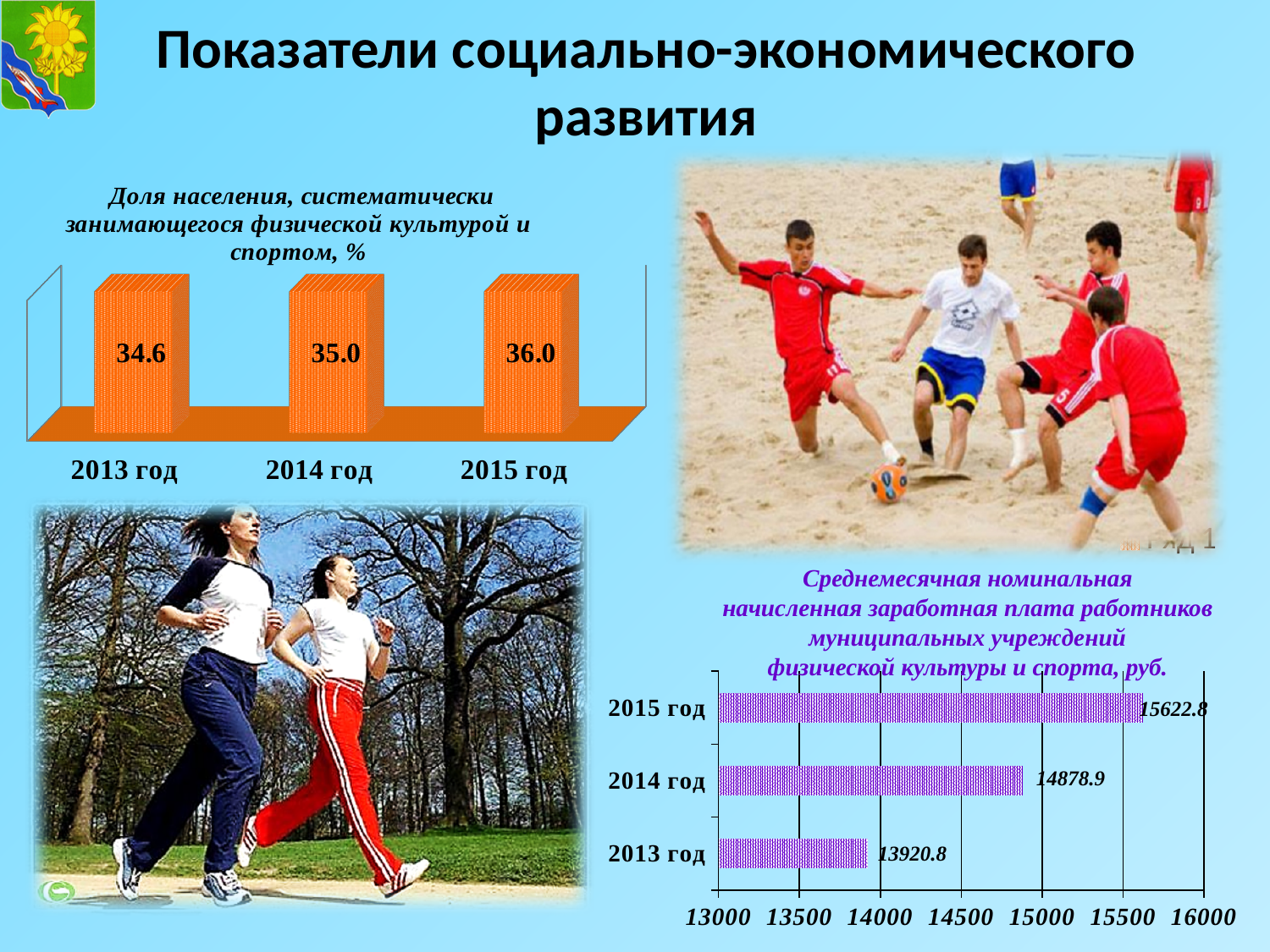
In the bottom-right chart (average monthly nominal wages of municipal physical culture and sport employees, руб.), is the value for 2015 год greater or less than 15500? greater In the bottom-right chart (average monthly nominal wages of municipal physical culture and sport employees, руб.), which year has the lowest value? 2013 год What kind of chart is the bottom-right chart (average monthly nominal wages of municipal physical culture and sport employees, руб.)? bar chart In the top-left chart (share of population regularly engaged in physical culture and sport, %), what is the difference between the 2015 год and 2013 год values? 1.4 How many years are shown in the top-left chart (share of population regularly engaged in physical culture and sport, %)? 3 In the top-left chart (share of population regularly engaged in physical culture and sport, %), which year has the highest value? 2015 год In the bottom-right chart (average monthly nominal wages of municipal physical culture and sport employees, руб.), what is the difference between the 2015 год and 2014 год values? 743.9 In the bottom-right chart (average monthly nominal wages of municipal physical culture and sport employees, руб.), what is the value for 2014 год? 14878.9 In the top-left chart (share of population regularly engaged in physical culture and sport, %), do the values rise or fall from 2013 to 2015? rise In the bottom-right chart (average monthly nominal wages of municipal physical culture and sport employees, руб.), what is the value for 2013 год? 13920.8 In the top-left chart (share of population regularly engaged in physical culture and sport, %), what is the value for 2013 год? 34.6 In the top-left chart (share of population regularly engaged in physical culture and sport, %), what is the value for 2014 год? 35.0